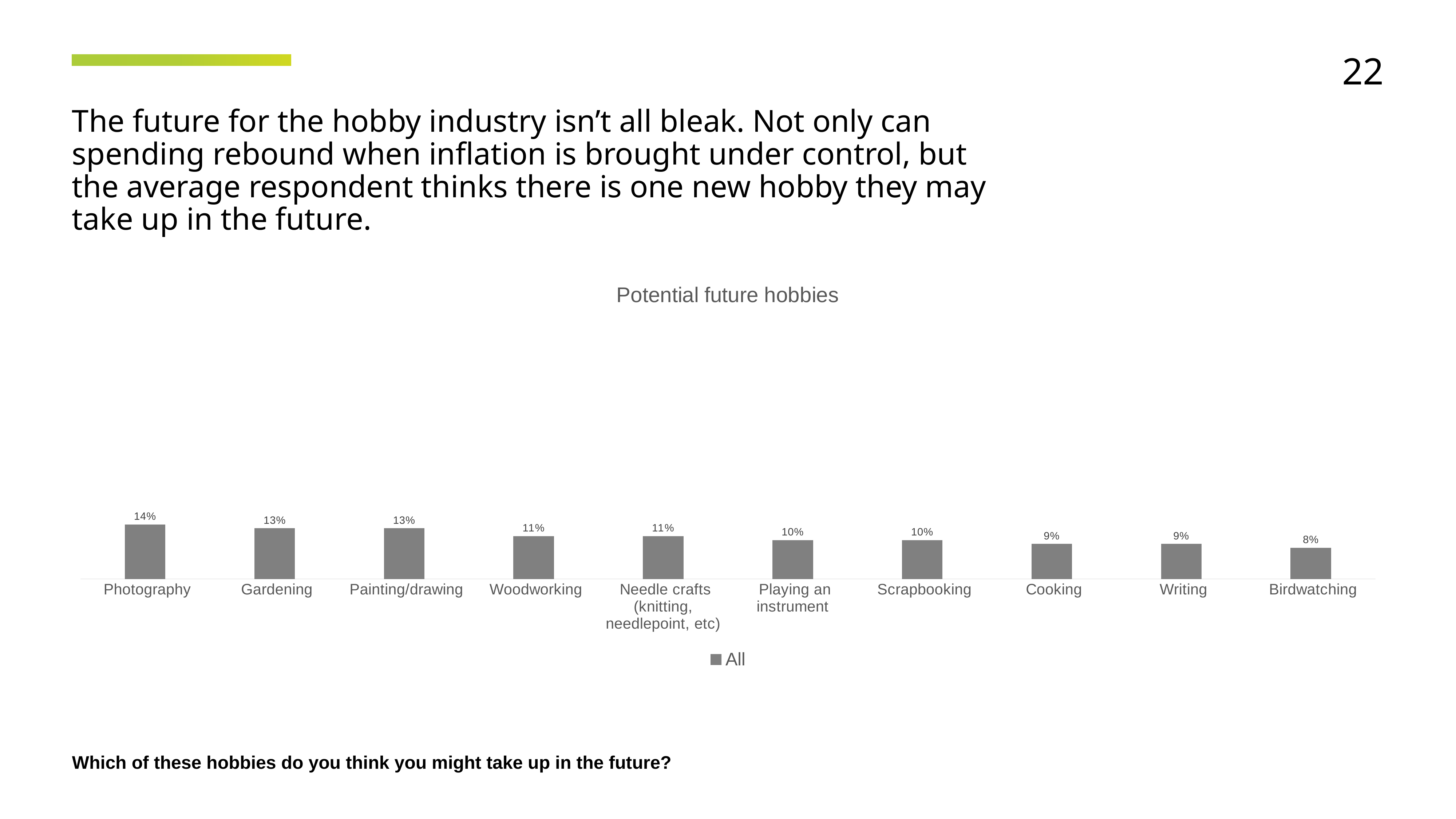
Which hobby has the highest value? Photography What is the value for Woodworking? 11% What is the difference between the values for Photography and Birdwatching? 6% What is the title of the chart? Potential future hobbies What is the value for Scrapbooking? 10% What kind of chart is shown? Bar chart How many hobbies are shown in the chart? 10 Which is larger, the value for Gardening or the value for Cooking? Gardening Which hobby has the lowest value? Birdwatching What is the value for Birdwatching? 8% What is the value for Photography? 14% How many series does the legend list? 1